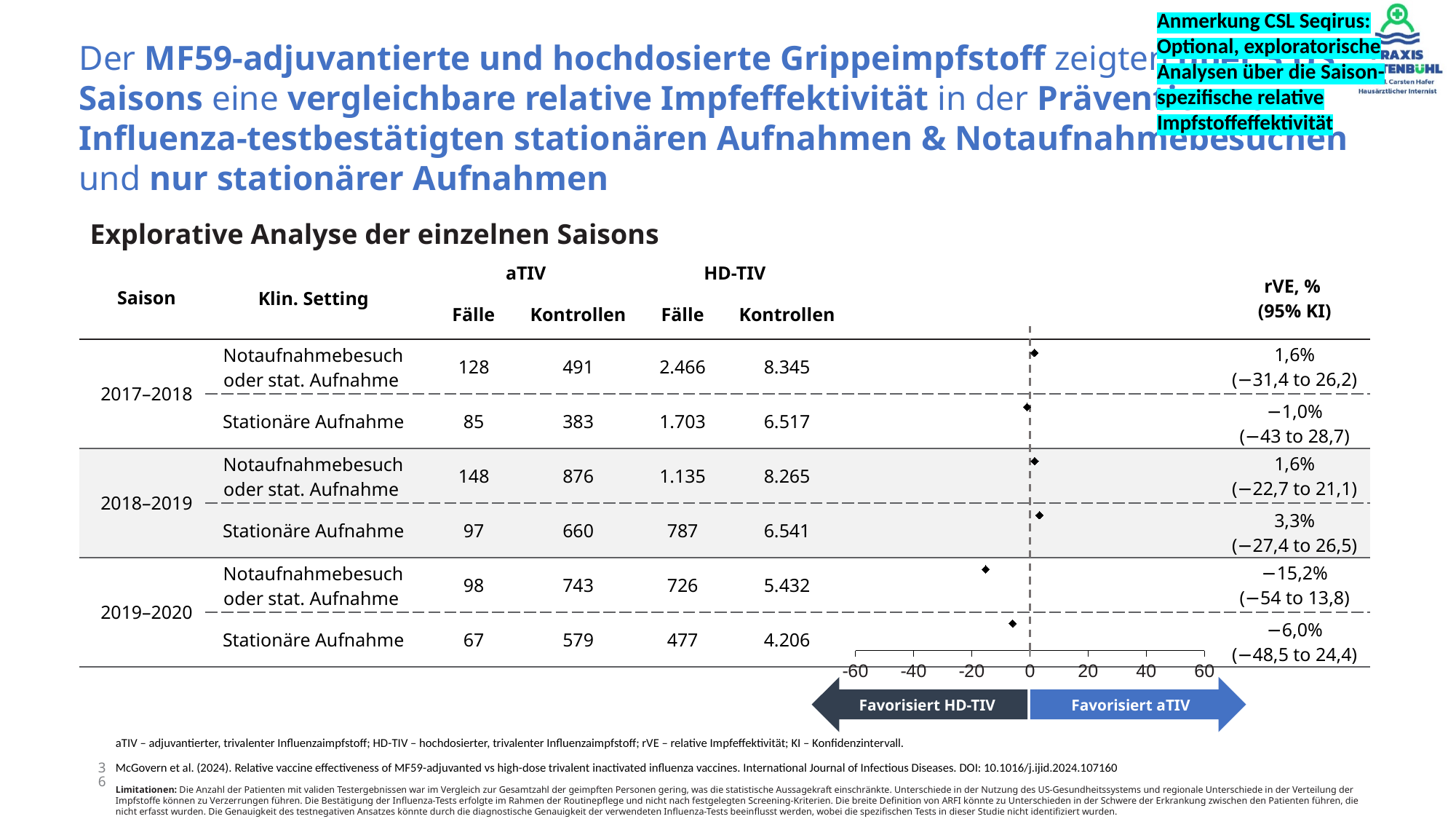
How many of the plotted rVE point estimates are negative? 3 What is the rVE, % for the 2018–2019 season, Stationäre Aufnahme? 3,3% Which season and setting has the lowest rVE, %? 2019–2020, Notaufnahmebesuch oder stat. Aufnahme What kind of chart is used to display the rVE values? Forest plot What is the rVE, % for the 2019–2020 season, Notaufnahmebesuch oder stat. Aufnahme? −15,2% Which has the larger rVE: 2017–2018 Stationäre Aufnahme or 2018–2019 Stationäre Aufnahme? 2018–2019 Stationäre Aufnahme What is the difference in rVE between the 2019–2020 Stationäre Aufnahme (−6,0%) and the 2019–2020 Notaufnahmebesuch oder stat. Aufnahme (−15,2%)? 9,2 percentage points Is the rVE point for 2019–2020 Notaufnahmebesuch oder stat. Aufnahme greater or less than 0? less Which season and setting has the highest rVE, %? 2018–2019, Stationäre Aufnahme What is the 95% KI for the rVE of the 2017–2018 season, Notaufnahmebesuch oder stat. Aufnahme? (−31,4 to 26,2) How many rVE point estimates are plotted in the forest plot? 6 Which vaccine is favoured on the left side of the rVE axis, according to the arrow label? HD-TIV